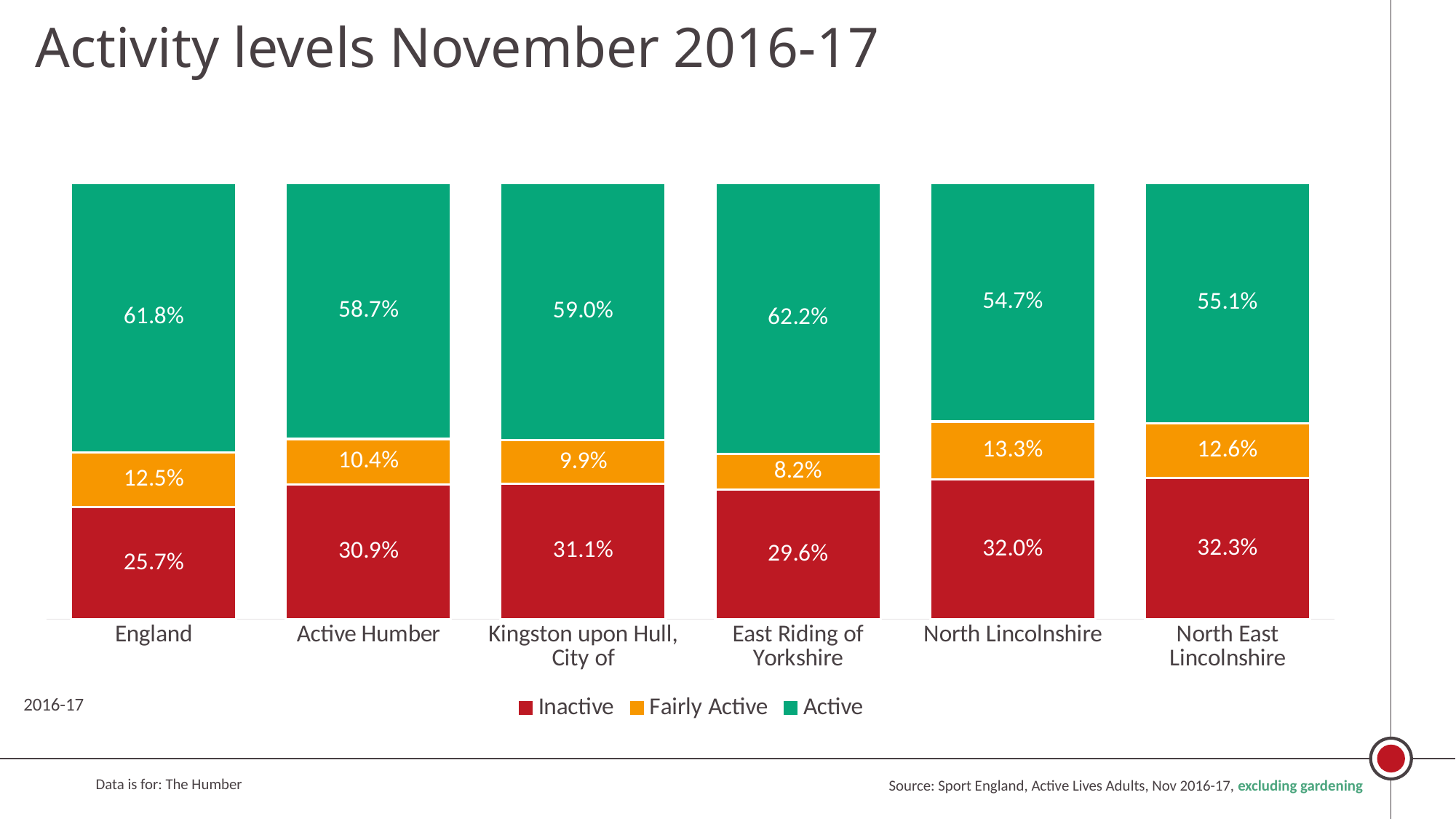
What is the Active percentage for East Riding of Yorkshire? 62.2% Which area has the highest Inactive percentage? North East Lincolnshire What kind of chart is shown on the slide? Stacked bar chart Which area has the lowest Fairly Active percentage? East Riding of Yorkshire Which area has the lowest Active percentage? North Lincolnshire Which has a larger Inactive percentage, Kingston upon Hull, City of or Active Humber? Kingston upon Hull, City of What is the Inactive percentage for England? 25.7% What is the difference in percentage points between the Active share for England and for Active Humber? 3.1 How many areas are shown on the x axis? 6 Which area has the highest Active percentage? East Riding of Yorkshire How many series does the legend list? 3 What is the Fairly Active percentage for North Lincolnshire? 13.3%